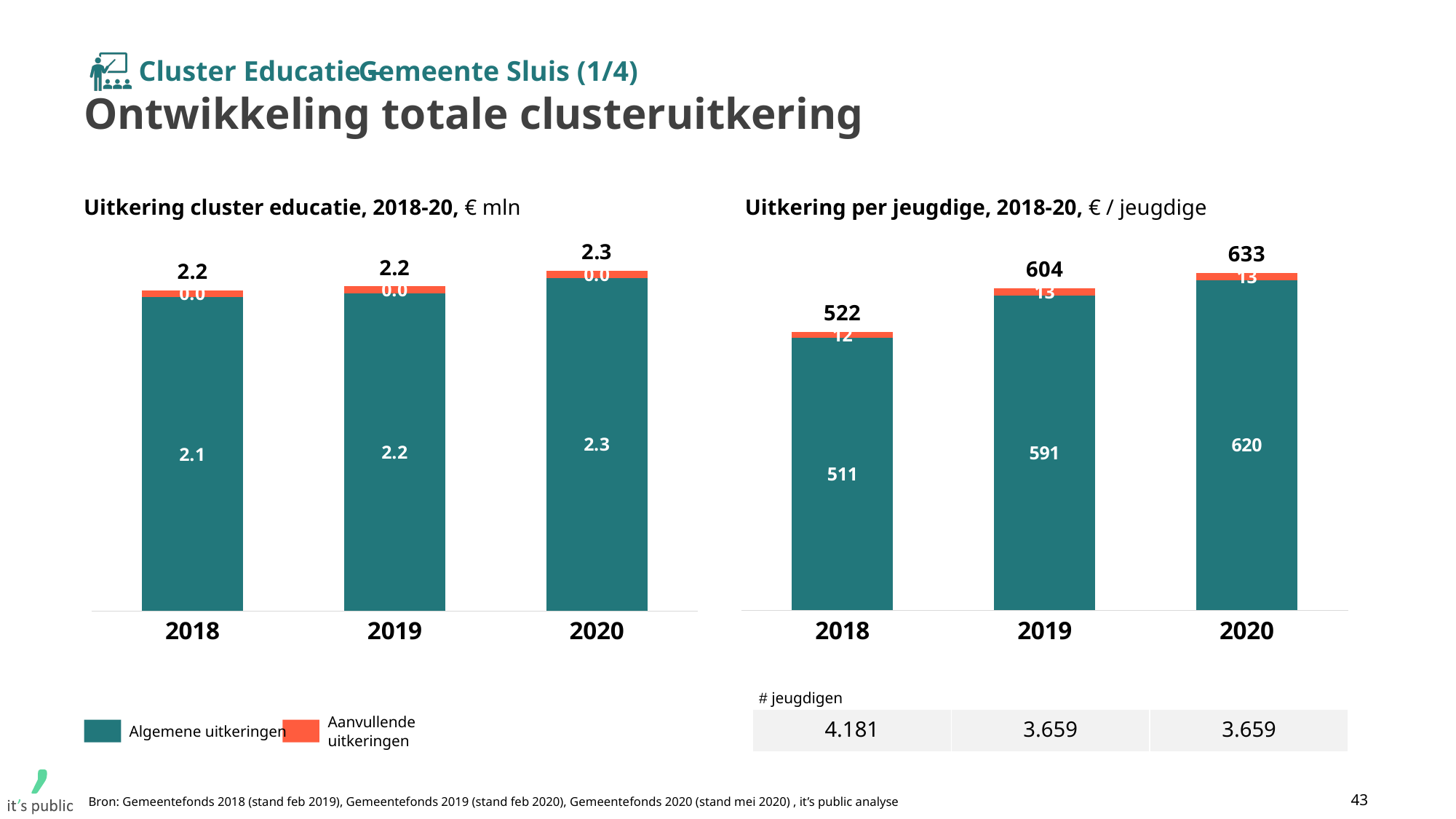
In the chart 'Uitkering cluster educatie, 2018-20', what is the value of Algemene uitkeringen for 2018? 2.1 In the chart 'Uitkering per jeugdige, 2018-20', what is the difference between the total for 2020 and the total for 2018? 111 How many series does the legend list for the charts on this slide? 2 In the chart 'Uitkering per jeugdige, 2018-20', what is the difference in Algemene uitkeringen between 2019 and 2018? 80 In the chart 'Uitkering per jeugdige, 2018-20', which year has the lowest total? 2018 In the chart 'Uitkering per jeugdige, 2018-20', what is the total value for 2019? 604 In the chart 'Uitkering per jeugdige, 2018-20', do the totals rise or fall from 2018 to 2020? rise In the chart 'Uitkering per jeugdige, 2018-20', what is the value of Algemene uitkeringen for 2018? 511 What kind of chart is 'Uitkering cluster educatie, 2018-20'? stacked bar chart In the chart 'Uitkering per jeugdige, 2018-20', what is the value of Aanvullende uitkeringen for 2020? 13 In the chart 'Uitkering per jeugdige, 2018-20', which year has the highest total? 2020 In the chart 'Uitkering cluster educatie, 2018-20', what is the total value for 2020? 2.3